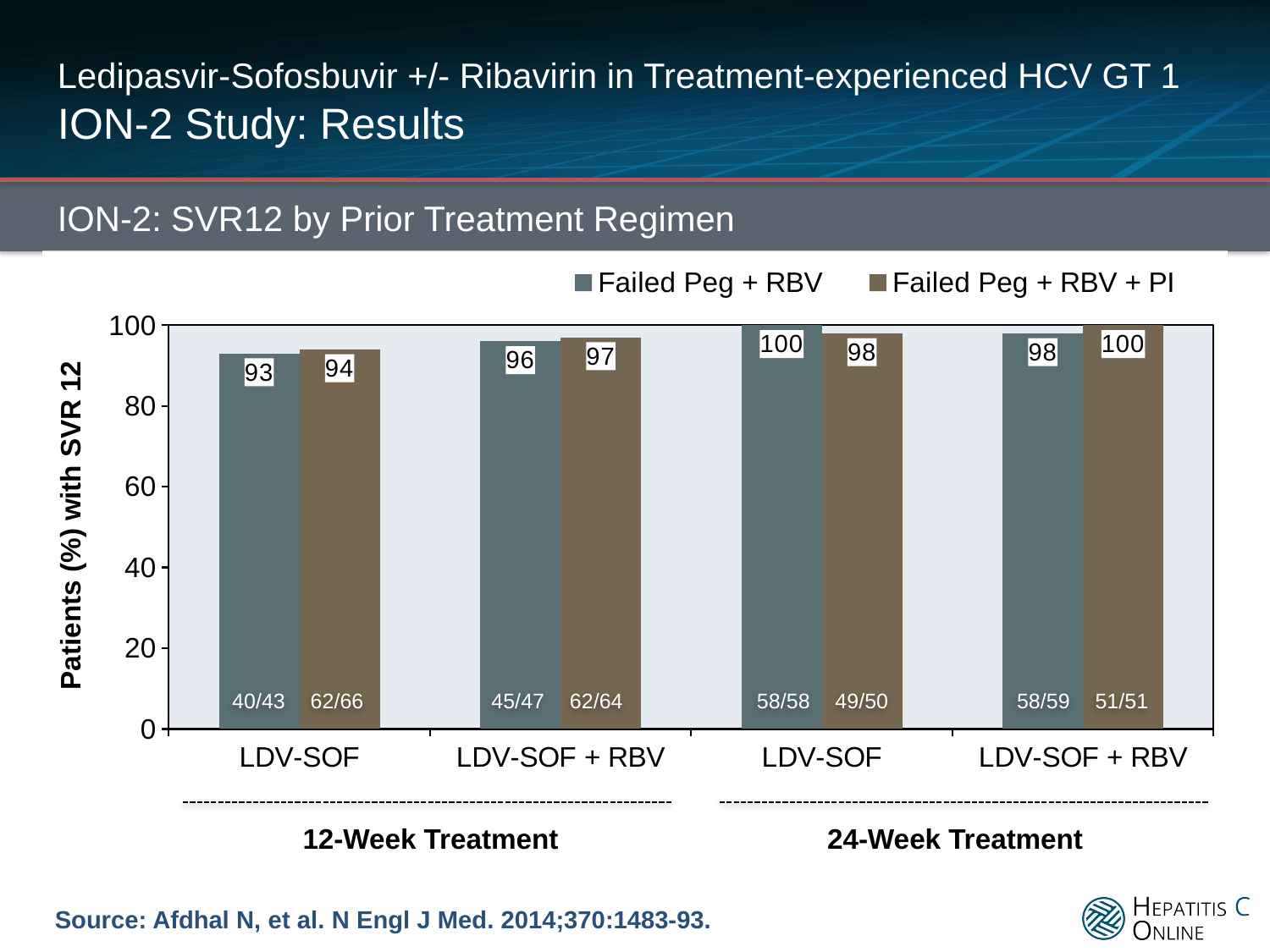
What is the difference in SVR12 rate between the Failed Peg + RBV + PI group and the Failed Peg + RBV group for LDV-SOF in the 12-Week Treatment arm? 1 How many series does the legend list? 2 What is the SVR12 rate for the Failed Peg + RBV group with LDV-SOF in the 24-Week Treatment arm? 100 What is the SVR12 rate for the Failed Peg + RBV group with LDV-SOF in the 12-Week Treatment arm? 93 Which treatment group has the lowest SVR12 rate for the Failed Peg + RBV series? LDV-SOF (12-Week Treatment) For LDV-SOF in the 24-Week Treatment arm, which series has the higher SVR12 rate: Failed Peg + RBV or Failed Peg + RBV + PI? Failed Peg + RBV What is the label of the y axis? Patients (%) with SVR 12 What is the SVR12 rate for the Failed Peg + RBV + PI group with LDV-SOF + RBV in the 24-Week Treatment arm? 100 What is the title of the chart? ION-2: SVR12 by Prior Treatment Regimen What is the SVR12 rate for the Failed Peg + RBV + PI group with LDV-SOF + RBV in the 12-Week Treatment arm? 97 How many treatment categories are shown on the x axis? 4 What kind of chart is shown on the slide? Bar chart